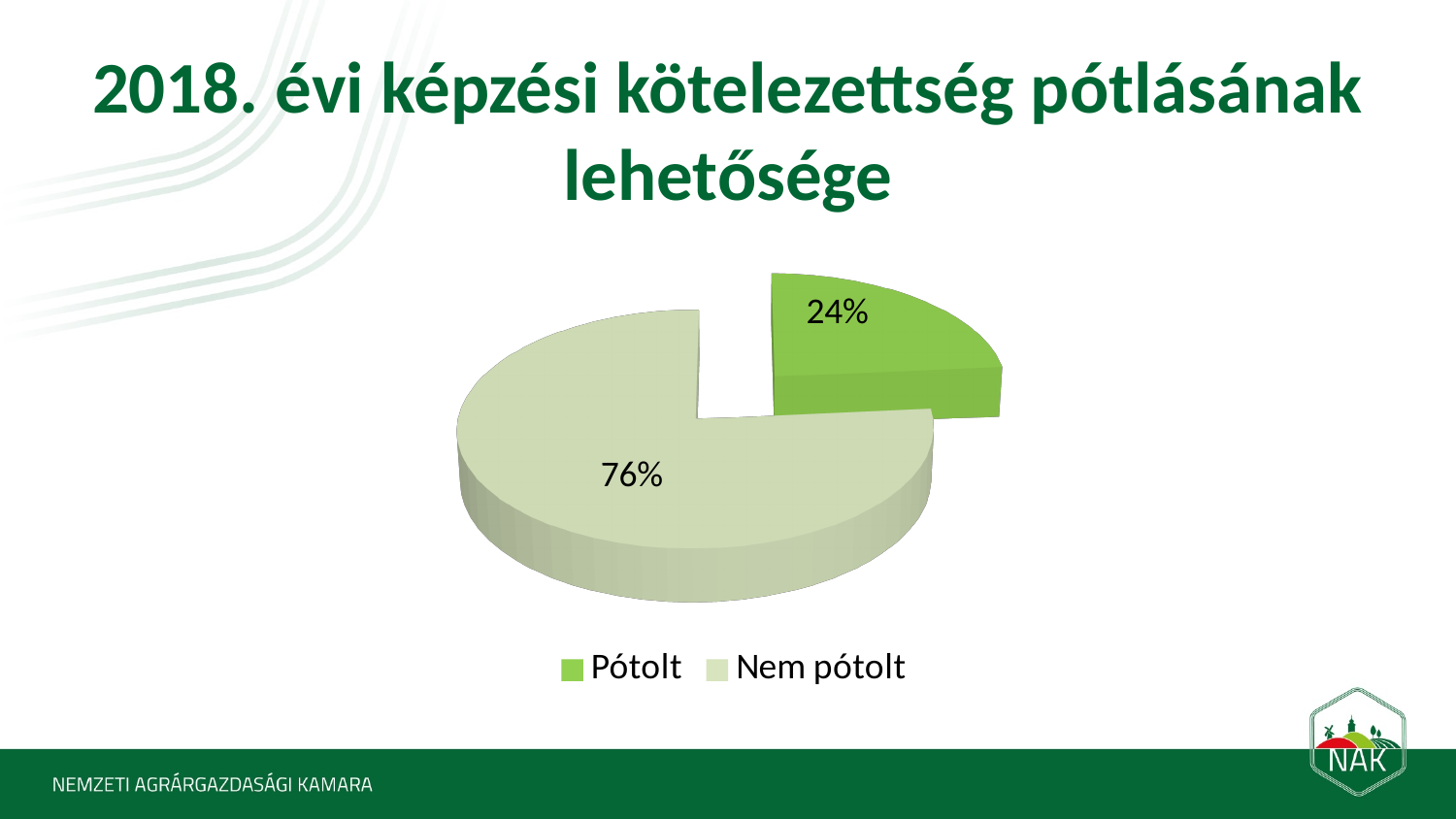
Which category has the largest slice of the pie? Nem pótolt How many slices does the pie chart have? 2 How many entries does the legend list? 2 Which category has the smallest slice of the pie? Pótolt What share of the pie does the "Pótolt" slice represent? 24% Which is larger, the "Pótolt" slice or the "Nem pótolt" slice? Nem pótolt What is the difference in percentage points between the "Nem pótolt" and "Pótolt" slices? 52 What is the title of the slide containing the chart? 2018. évi képzési kötelezettség pótlásának lehetősége What share of the pie does the "Nem pótolt" slice represent? 76% What kind of chart is shown on the slide? Pie chart Which legend entry is shown in the darker green colour? Pótolt